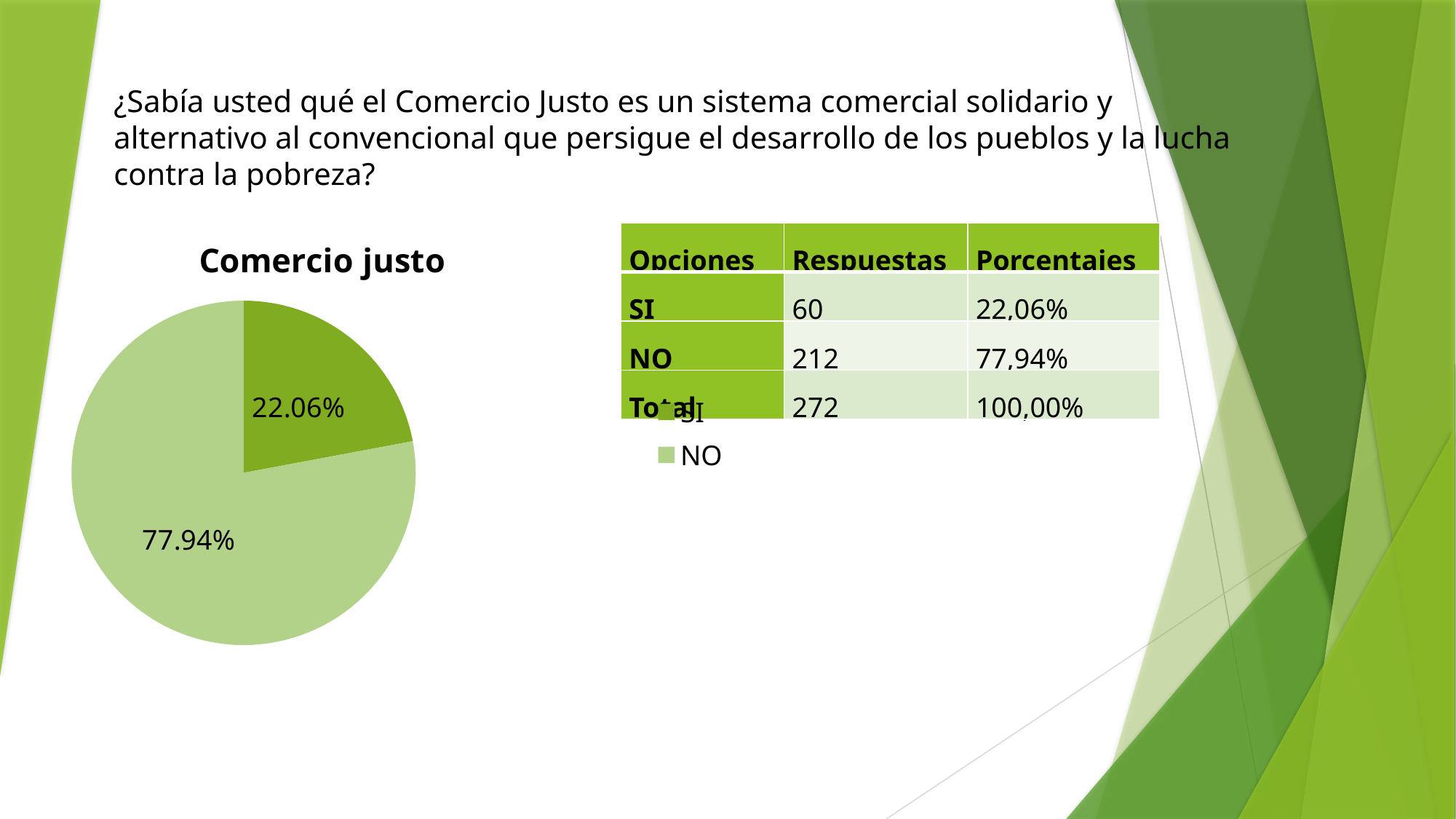
What type of chart is shown on the slide? pie chart What is the title of the chart? Comercio justo Which is larger in the pie chart, the SI slice or the NO slice? NO What percentage does the NO slice show in the pie chart? 77.94% Is the SI slice of the pie chart greater or less than 50%? less What is the difference in percentage points between the NO slice and the SI slice? 55.88 What percentage does the SI slice show in the pie chart? 22.06% Which slice of the pie chart is the smallest? SI Which slice of the pie chart is the largest? NO What share of the pie does the NO slice represent? 77.94% How many entries does the chart legend list? 2 How many slices does the pie chart have? 2